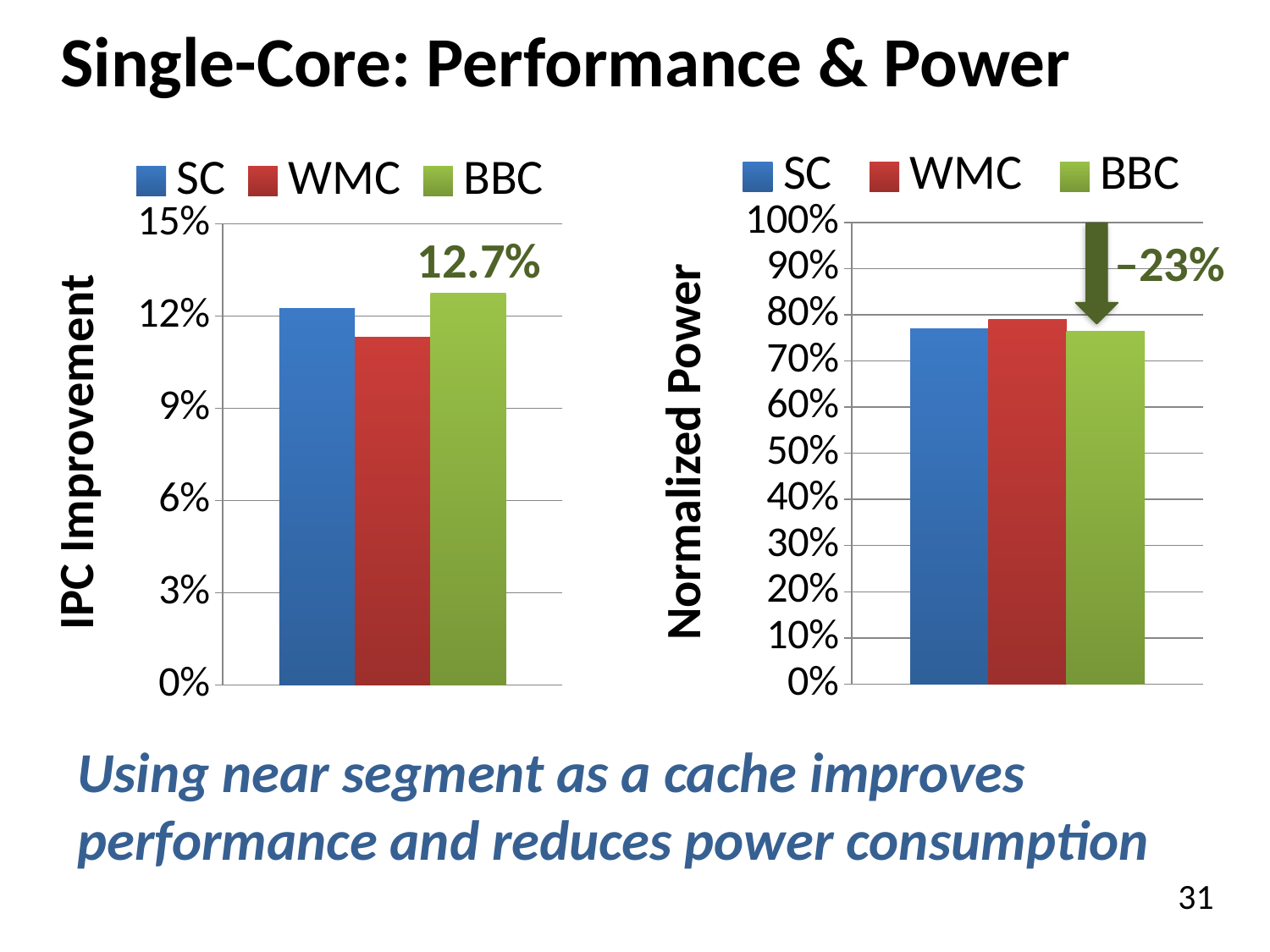
In the right chart (Normalized Power), is the value for WMC greater or less than 70%? greater In the left chart (IPC Improvement), which series has the highest value? BBC In the left chart (IPC Improvement), which series has the lowest value? WMC In the left chart (IPC Improvement), what is the value for BBC? 12.7% In the right chart (Normalized Power), which series has the highest value? WMC In the right chart, what annotation is shown next to the arrow above the BBC bar? –23% In the left chart (IPC Improvement), is the value for WMC greater or less than 12%? less In the left chart (IPC Improvement), which is larger, the value for SC or the value for WMC? SC In the right chart (Normalized Power), is the value for BBC greater or less than 80%? less How many series does the legend of the right chart (Normalized Power) list? 3 What kind of chart is the left chart (IPC Improvement)? bar chart